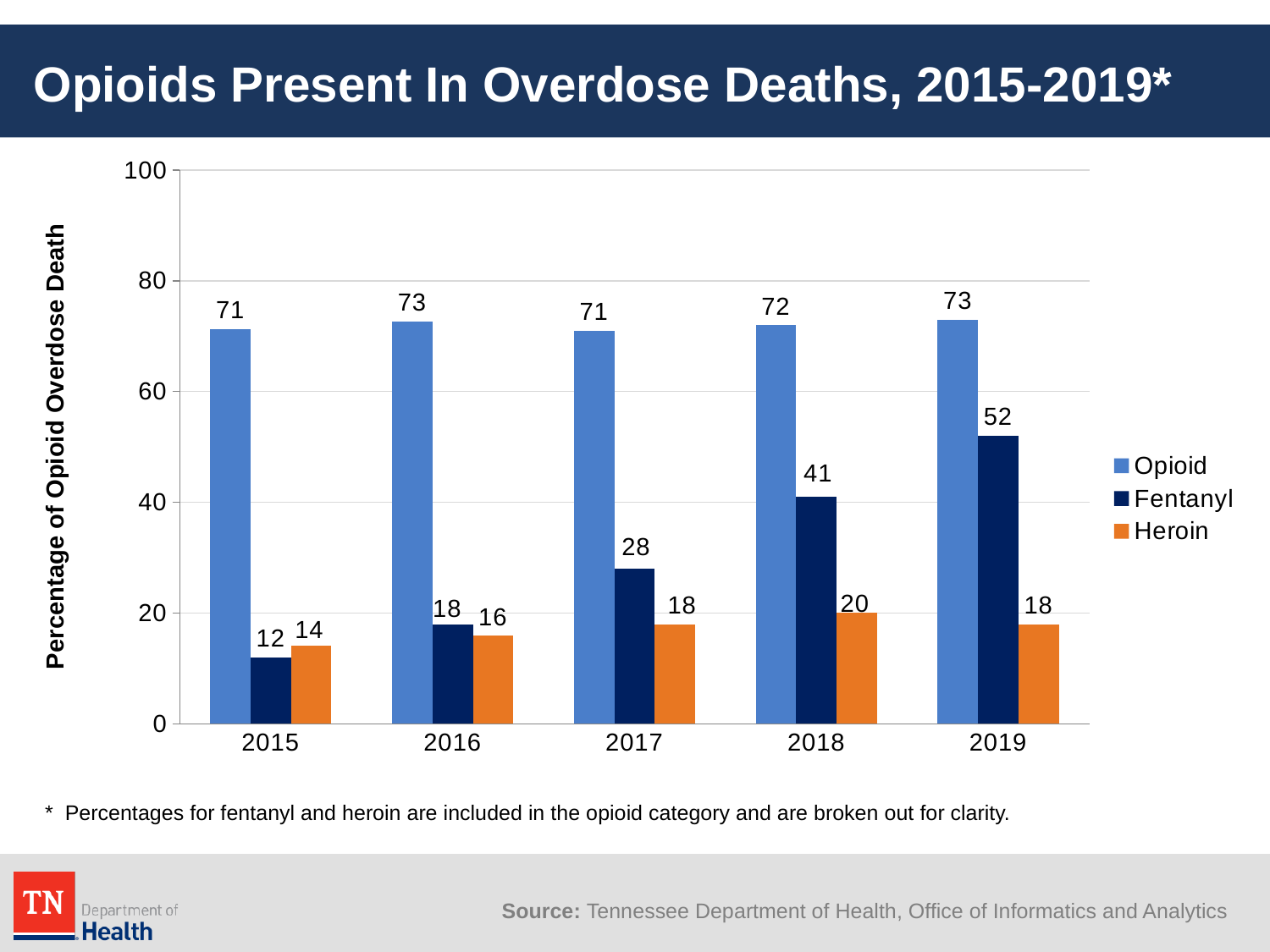
In which year is the Fentanyl value lowest? 2015 What is the Heroin value for 2015? 14 How many series does the legend list? 3 In which year is the Heroin value highest? 2018 Which is larger, the Fentanyl value for 2016 or the Heroin value for 2016? Fentanyl What is the y-axis label of the chart? Percentage of Opioid Overdose Death What is the Opioid value for 2017? 71 What kind of chart is shown? bar chart What is the difference between the Fentanyl values for 2019 and 2018? 11 Does the Fentanyl value rise or fall from 2015 to 2019? rise How many years are shown on the x axis? 5 What is the Fentanyl value for 2019? 52